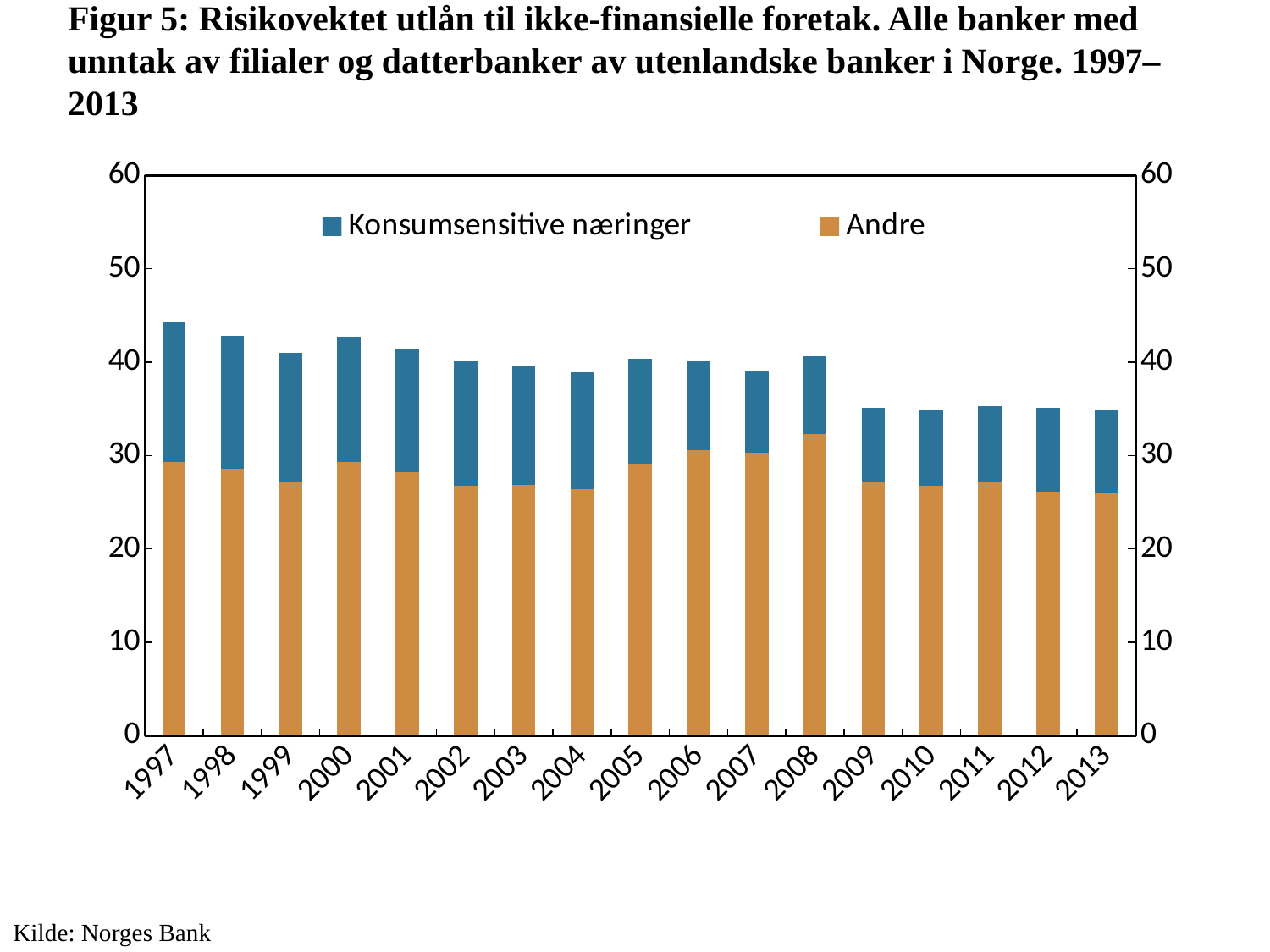
Which year has the highest total bar? 1997 Which year has the highest value for Andre? 2008 Do the total bars generally rise or fall from 1997 to 2013? fall Is the total bar for 2013 greater or less than 40? less Is the value for Andre in 2013 greater or less than 30? less How many years are shown on the x axis? 17 How many series does the legend list? 2 Is the value for Andre in 2008 greater or less than 30? greater What kind of chart is shown on the slide? Stacked bar chart Which is larger, the total bar for 1997 or the total bar for 2013? 1997 What are the two series named in the legend? Konsumsensitive næringer and Andre